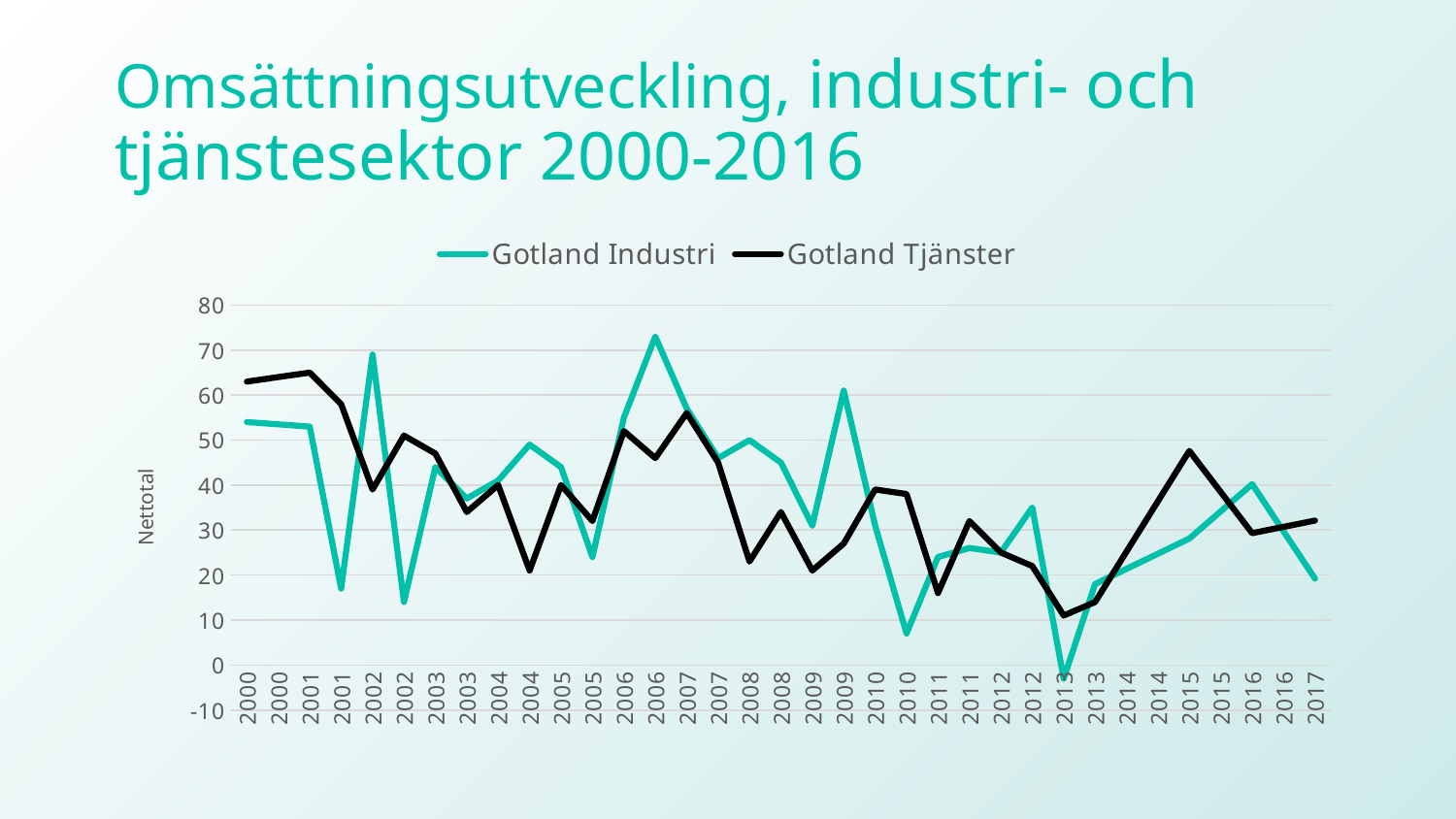
Which series reaches the highest value anywhere on the chart? Gotland Industri Which series has the higher value at 2017? Gotland Tjänster How many series does the legend list? 2 Is the 2017 value for Gotland Tjänster greater or less than 40? less What is the label on the vertical axis? Nettotal Is the first 2013 value for Gotland Industri greater or less than 0? less Is the first 2000 value for Gotland Tjänster greater or less than 60? greater Which series has the higher value at the first 2000 point? Gotland Tjänster Does the Gotland Industri line rise or fall from 2016 to 2017? Fall What are the two series named in the legend? Gotland Industri and Gotland Tjänster What type of chart is shown on the slide? Line chart